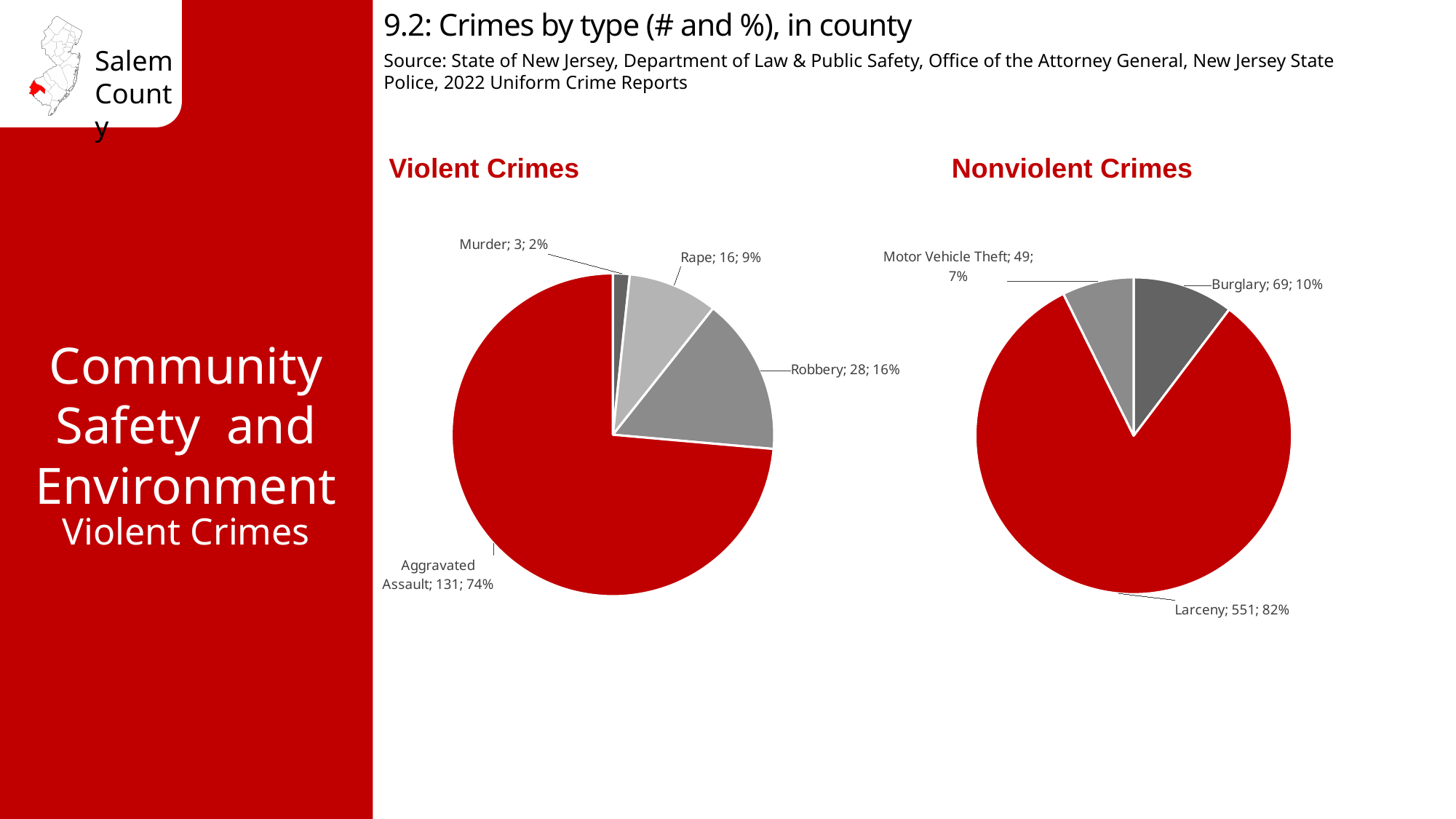
In the Violent Crimes chart, how many aggravated assaults are shown? 131 In the Nonviolent Crimes chart, how many larcenies are shown? 551 In the Violent Crimes chart, which category has the largest slice? Aggravated Assault In the Violent Crimes chart, what is the difference between the number of robberies and the number of rapes? 12 In the Nonviolent Crimes chart, which is larger, Burglary or Motor Vehicle Theft? Burglary In the Violent Crimes chart, what share of the pie is Robbery? 16% In the Nonviolent Crimes chart, how many categories are shown? 3 In the Nonviolent Crimes chart, what is the difference between the number of burglaries and motor vehicle thefts? 20 In the Violent Crimes chart, which category has the smallest slice? Murder In the Nonviolent Crimes chart, what share of the pie is Motor Vehicle Theft? 7% What type of chart is used for the Nonviolent Crimes data? Pie chart In the Violent Crimes chart, how many categories are shown? 4